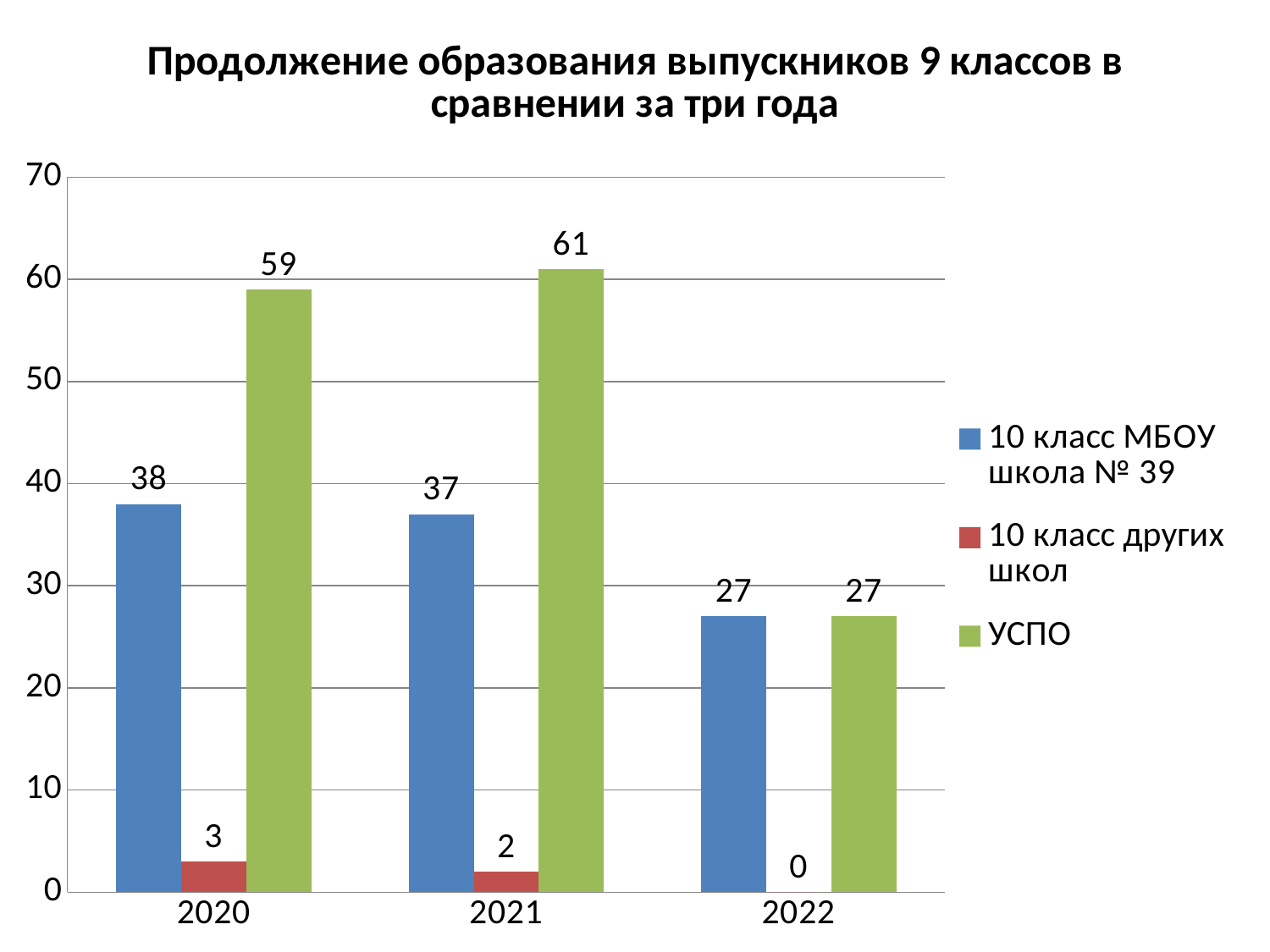
Does the value for 10 класс МБОУ школа № 39 rise or fall from 2020 to 2022? Fall How many series does the legend list? 3 What kind of chart is shown on the slide? Bar chart What colour represents УСПО in the chart? Green In which year is the value for 10 класс МБОУ школа № 39 lowest? 2022 Which is larger in 2020: 10 класс МБОУ школа № 39 or УСПО? УСПО What is the value for УСПО in 2021? 61 What is the difference between the УСПО value in 2021 and in 2020? 2 What is the value for 10 класс МБОУ школа № 39 in 2020? 38 In which year is the УСПО value highest? 2021 How many years are shown on the x axis? 3 What is the value for 10 класс других школ in 2022? 0